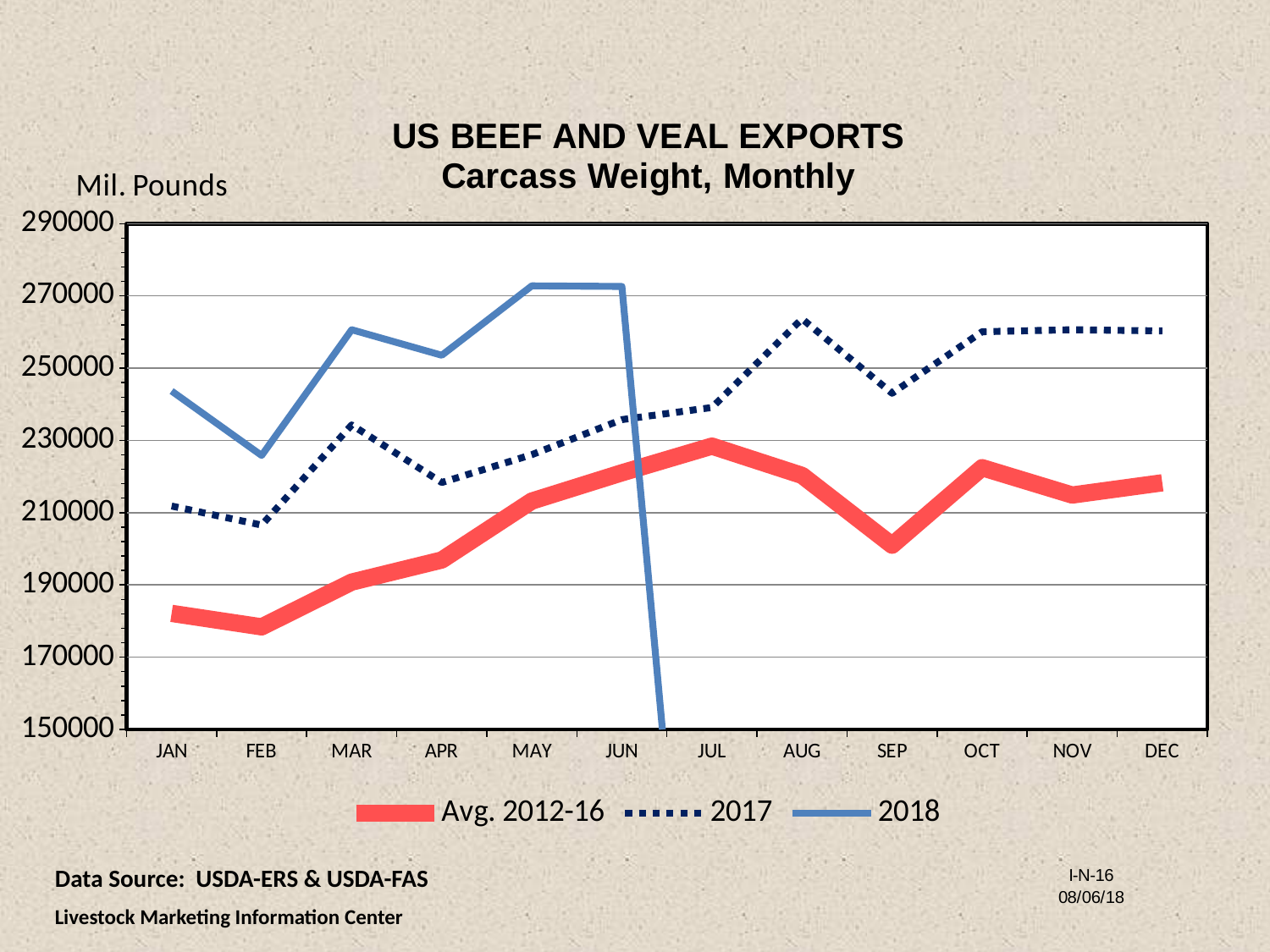
How many months are shown along the x axis? 12 What kind of chart is shown on the slide? line chart Does the Avg. 2012-16 series rise or fall from JAN to JUL? rise In which month is the Avg. 2012-16 series at its highest? JUL In JAN, which series has the larger value, 2017 or 2018? 2018 Is the value for 2017 in JAN greater or less than 230000? less Is the value for 2018 in JAN greater or less than 230000? greater Is the value for Avg. 2012-16 in JAN greater or less than 190000? less In which month is the 2018 series at its lowest? FEB How many series does the legend list? 3 Through which month does the 2018 series have plotted data? JUN